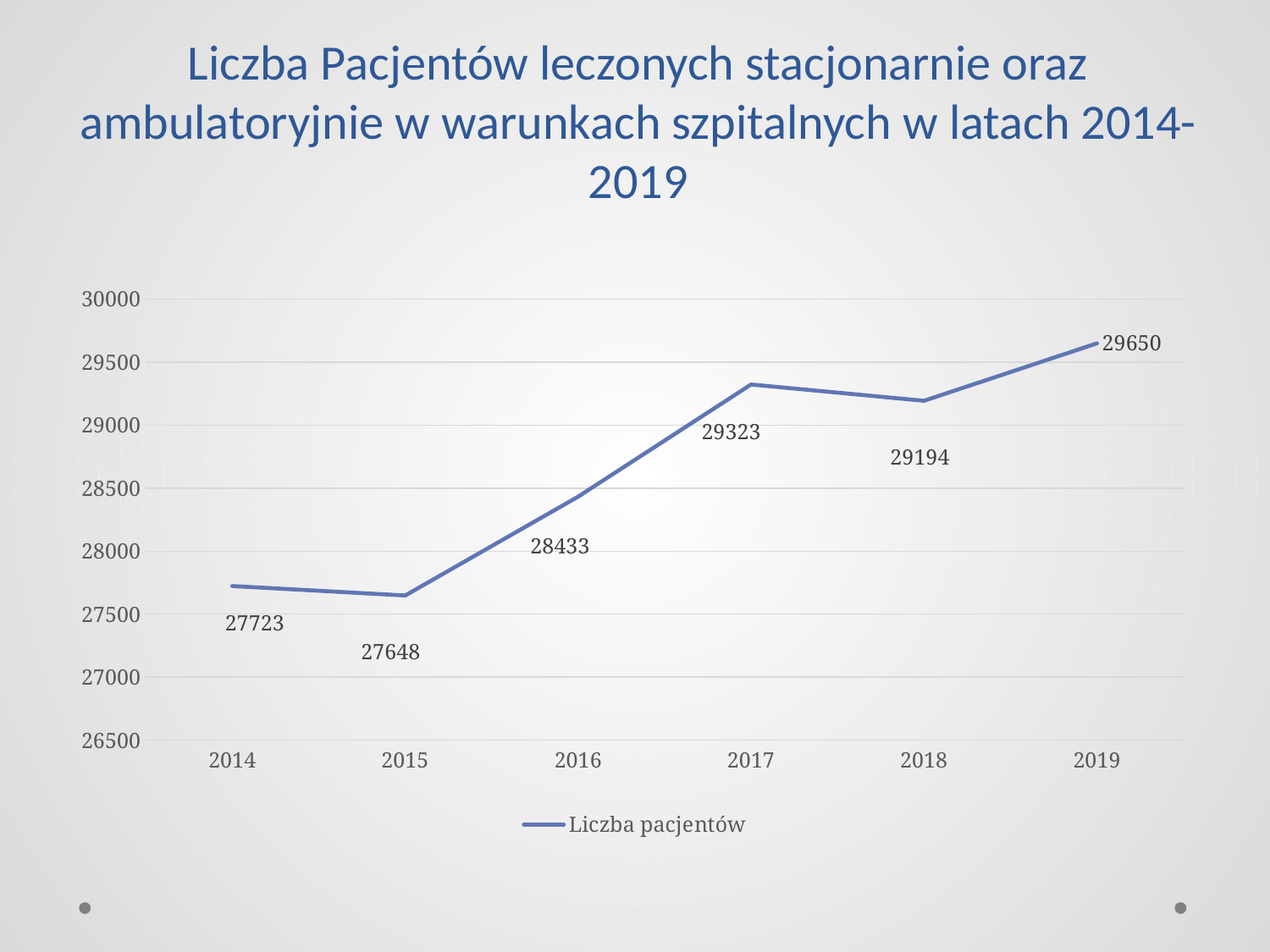
Which year has more patients, 2016 or 2018? 2018 Which year has the highest number of patients? 2019 What is the name of the series shown in the legend? Liczba pacjentów What is the number of patients in 2019? 29650 What is the number of patients in 2014? 27723 Is the number of patients in 2016 greater or less than 28500? less What is the difference between the number of patients in 2017 and in 2018? 129 What is the difference between the number of patients in 2019 and in 2014? 1927 How many years are shown on the x axis? 6 What is the number of patients in 2017? 29323 Which year has the lowest number of patients? 2015 What kind of chart is shown on the slide? line chart